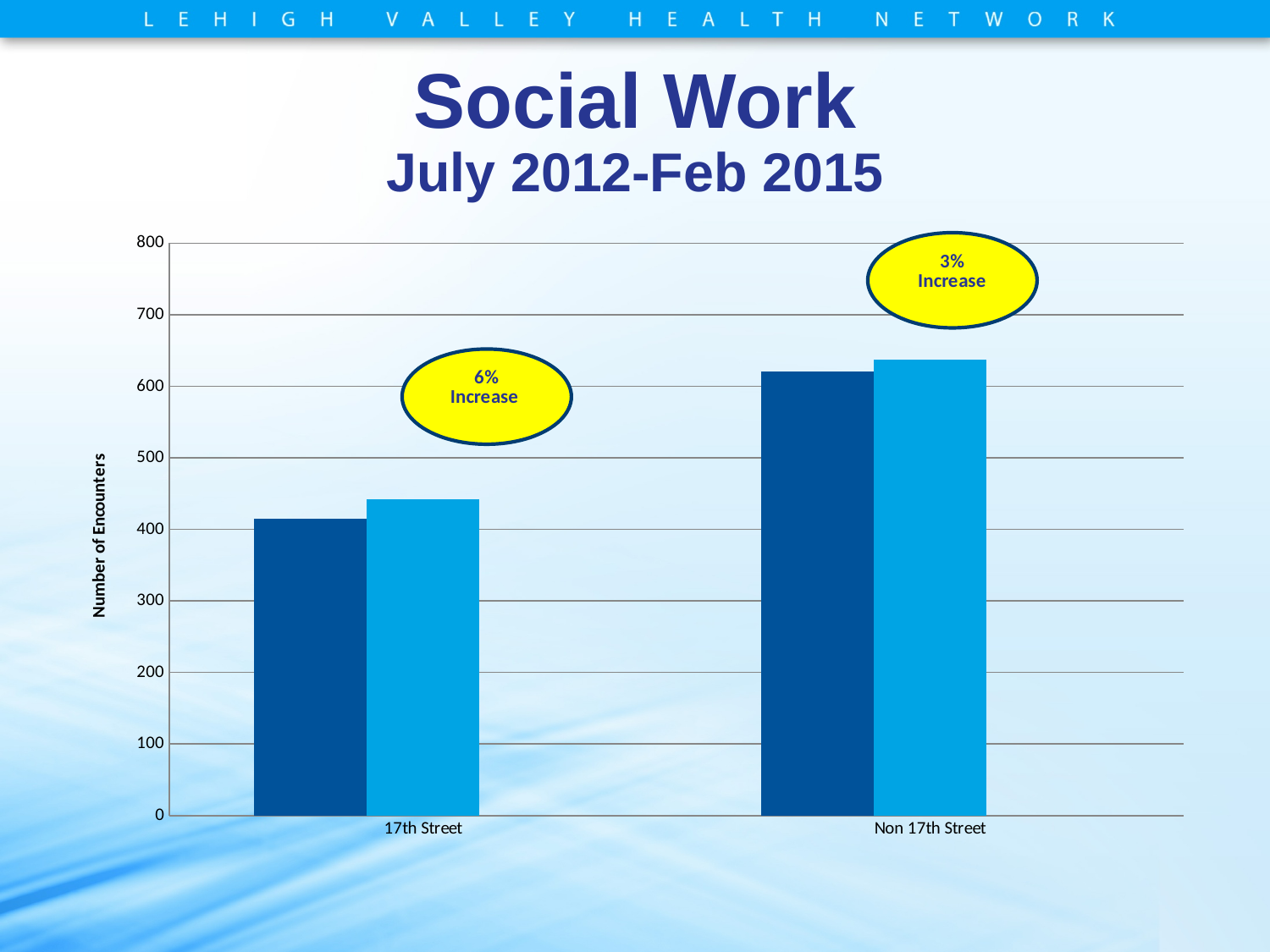
How many categories are shown on the x axis of the chart? 2 Is the value of the light blue bar for Non 17th Street greater or less than 700? less Is the value of the dark blue bar for Non 17th Street greater or less than 600? greater Which category has the shortest bars in the chart? 17th Street What is the label on the vertical axis of the chart? Number of Encounters What percentage increase is shown in the callout above the 17th Street bars? 6% Increase For 17th Street, which bar is taller, the dark blue bar or the light blue bar? the light blue bar What kind of chart is shown on the slide? bar chart Are the bars for Non 17th Street higher or lower than the bars for 17th Street? higher Is the value of the dark blue bar for 17th Street greater or less than 400? greater Which category has the tallest bars in the chart? Non 17th Street